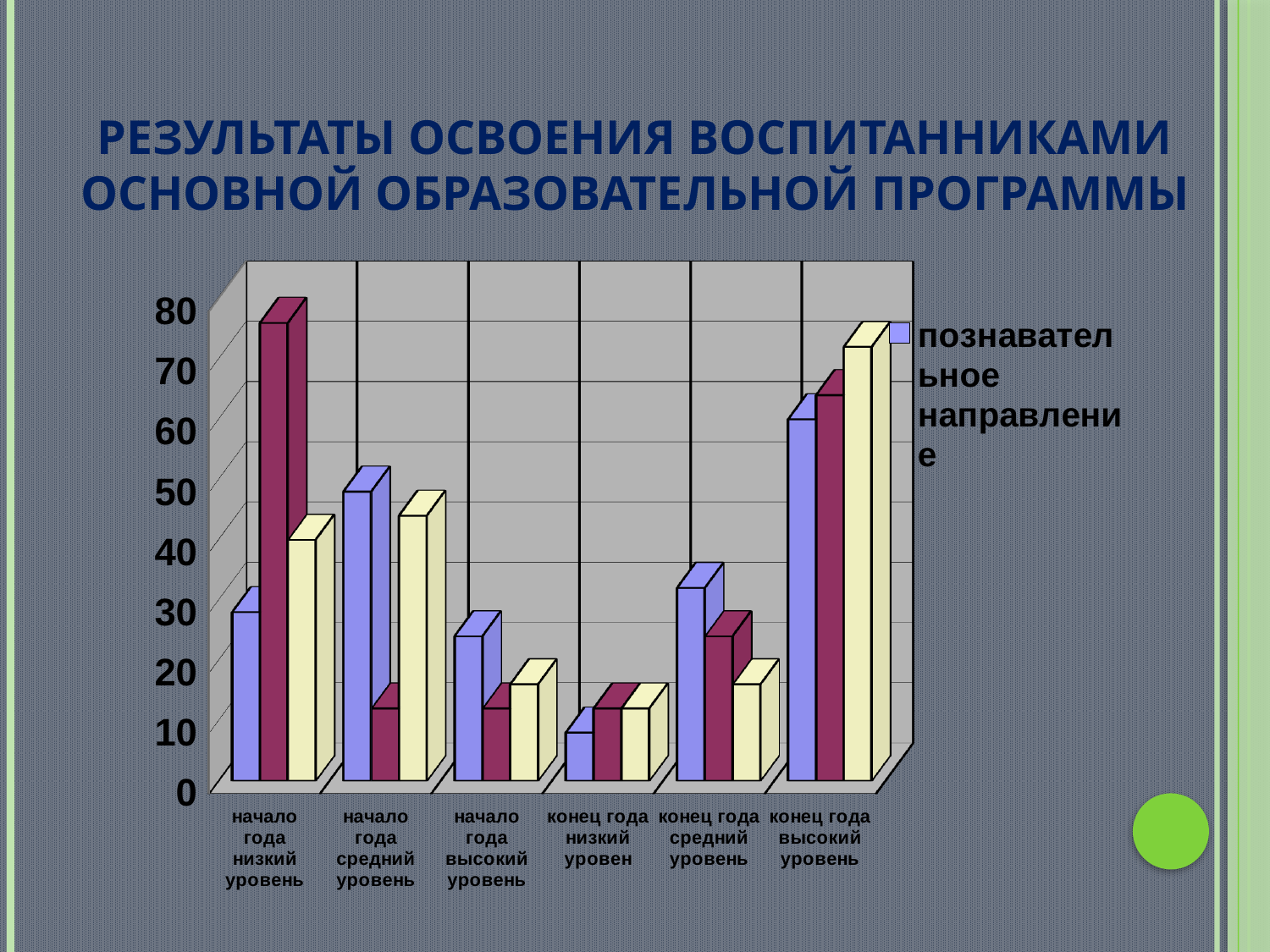
For the blue series (познавательное направление), which category has the lowest bar? конец года низкий уровен For the blue series (познавательное направление), which category has the highest bar? конец года высокий уровень How many categories are shown along the x axis of the chart? 6 What kind of chart is shown on the slide? bar chart What is the title of the slide containing the chart? РЕЗУЛЬТАТЫ ОСВОЕНИЯ ВОСПИТАННИКАМИ ОСНОВНОЙ ОБРАЗОВАТЕЛЬНОЙ ПРОГРАММЫ Which is larger: the blue bar for 'начало года средний уровень' or the blue bar for 'конец года средний уровень'? начало года средний уровень Is the value of the blue bar for 'начало года низкий уровень' greater or less than 20? greater Is the value of the maroon bar for 'начало года низкий уровень' greater or less than 70? greater Is the value of the maroon bar for 'начало года средний уровень' greater or less than 20? less Which series name is readable in the chart legend? познавательное направление